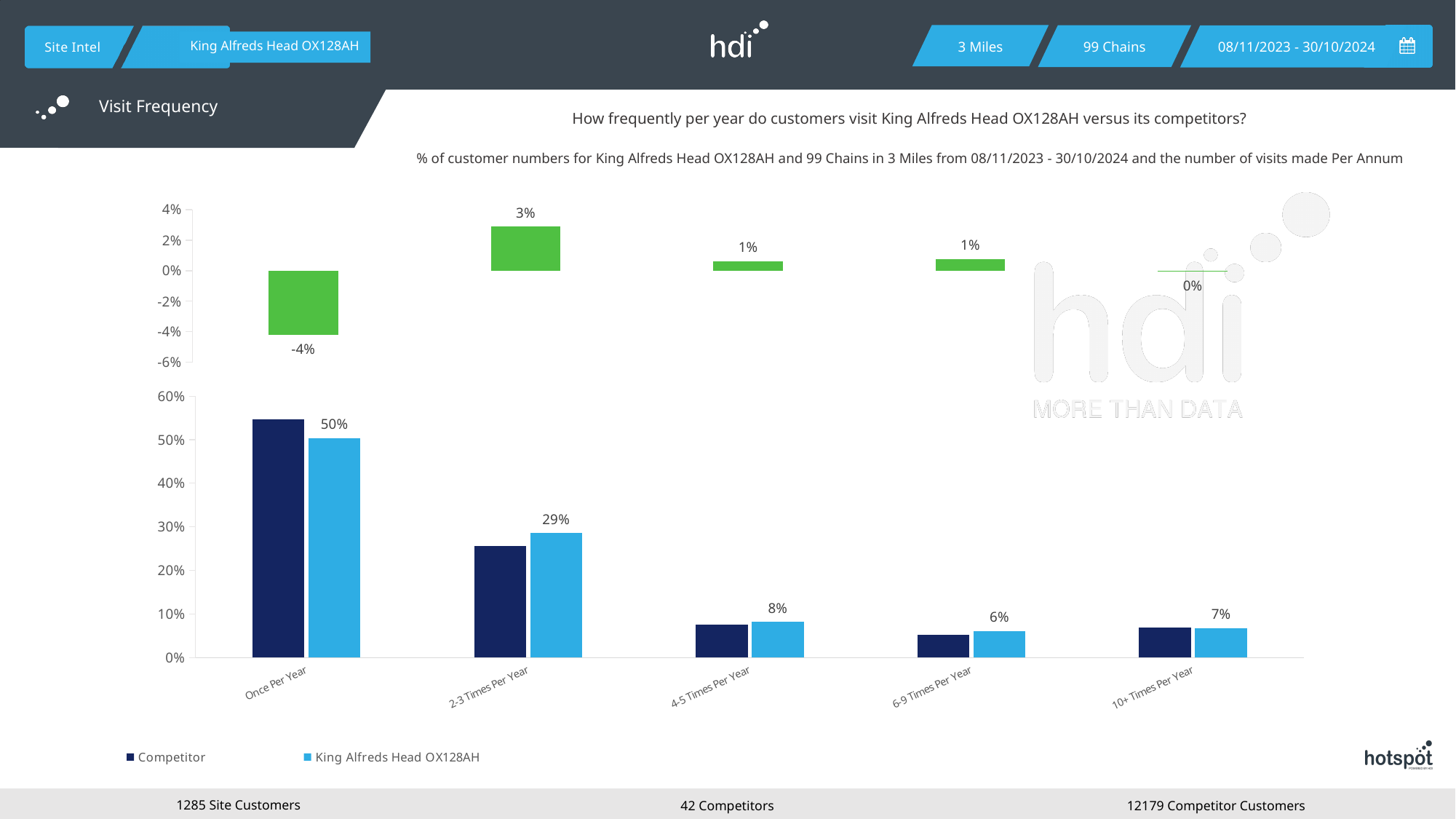
In the bottom bar chart, is the Competitor value for 2-3 Times Per Year greater or less than 30%? less In the bottom bar chart, which category has the highest value for King Alfreds Head OX128AH? Once Per Year In the bottom bar chart, which is larger for 2-3 Times Per Year: Competitor or King Alfreds Head OX128AH? King Alfreds Head OX128AH In the bottom bar chart, is the Competitor value for Once Per Year greater or less than 50%? greater In the bottom bar chart, which category has the lowest value for King Alfreds Head OX128AH? 6-9 Times Per Year In the bottom bar chart, what is the value for King Alfreds Head OX128AH for Once Per Year? 50% In the top chart, which category has the highest value? 2-3 Times Per Year In the bottom bar chart, what is the difference between the King Alfreds Head OX128AH values for Once Per Year and 2-3 Times Per Year? 21% How many series does the legend of the bottom bar chart list? 2 In the bottom bar chart, what is the value for King Alfreds Head OX128AH for 2-3 Times Per Year? 29% In the top chart, what is the value shown for Once Per Year? -4% In the bottom bar chart, what is the value for King Alfreds Head OX128AH for 6-9 Times Per Year? 6%